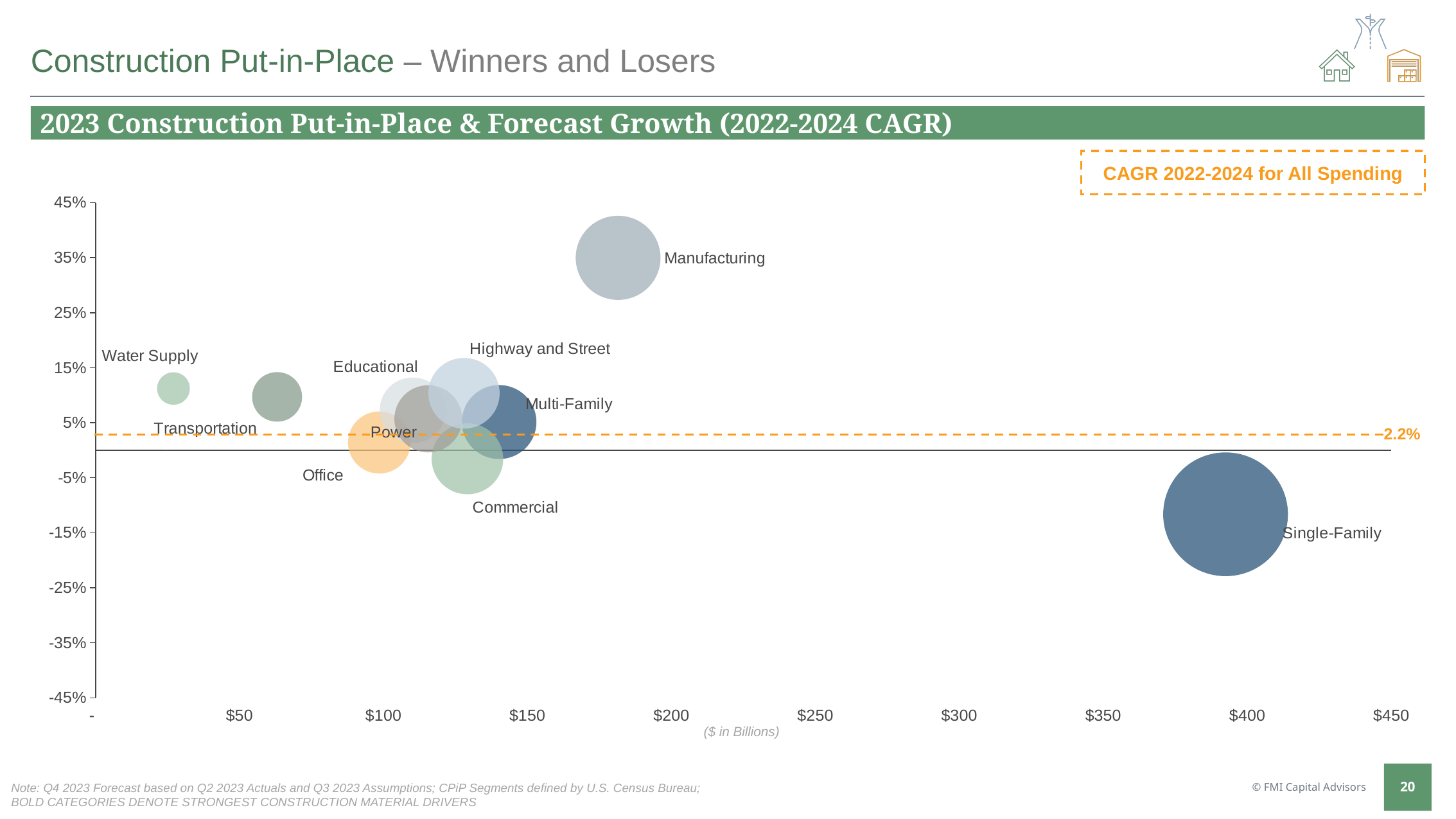
Which has the higher CAGR, Manufacturing or Commercial? Manufacturing Is the 2023 spending for Single-Family greater or less than $350 billion? greater Which segment has the largest 2023 construction put-in-place spending (furthest right on the x axis)? Single-Family Which segment has the highest 2022-2024 CAGR on the chart? Manufacturing What unit is shown for the x axis of the chart? $ in Billions What kind of chart is shown on the slide? Bubble chart Is the CAGR for Manufacturing greater or less than 25%? greater How many construction segments are plotted as bubbles on the chart? 10 Which segment has the smallest 2023 construction put-in-place spending (furthest left on the x axis)? Water Supply What is the CAGR 2022-2024 for all spending shown by the dashed line? 2.2% Which segment has the lowest 2022-2024 CAGR on the chart? Single-Family Is the CAGR for Single-Family greater or less than -5%? less